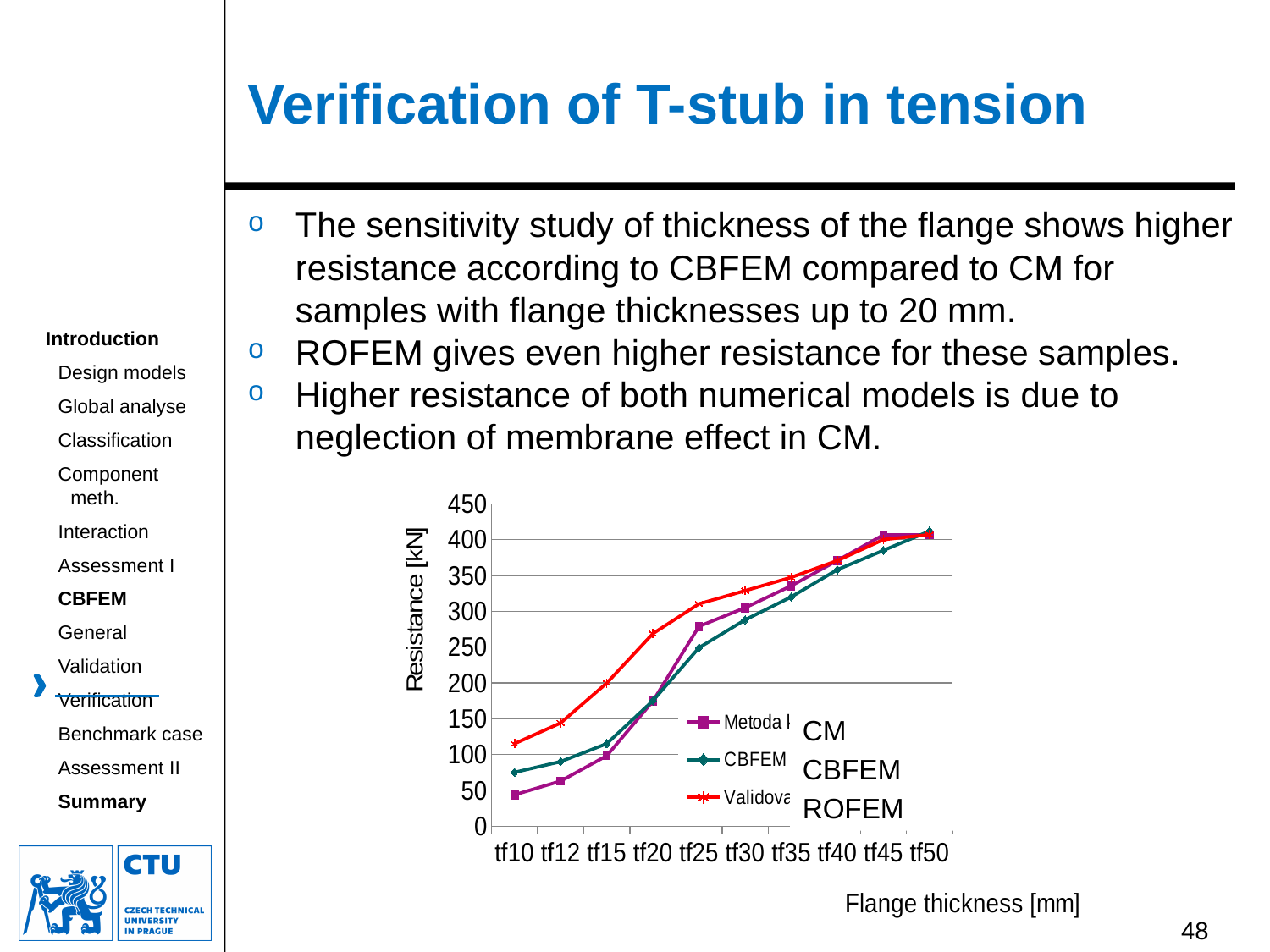
How many series does the chart's legend list? 3 Which series has the lowest resistance at tf10? CM How many flange thickness categories are plotted along the x axis? 10 What is the label of the chart's vertical axis? Resistance [kN] What kind of chart is shown on the slide? line chart Is the ROFEM value at tf10 greater or less than 100? greater Do the resistance values rise or fall as flange thickness increases from tf10 to tf50? rise Is the CM value at tf25 greater or less than 300? less Is the CM value at tf20 greater or less than 200? less Which series has the highest resistance at tf15? ROFEM At tf25, which is larger: the ROFEM value or the CBFEM value? ROFEM